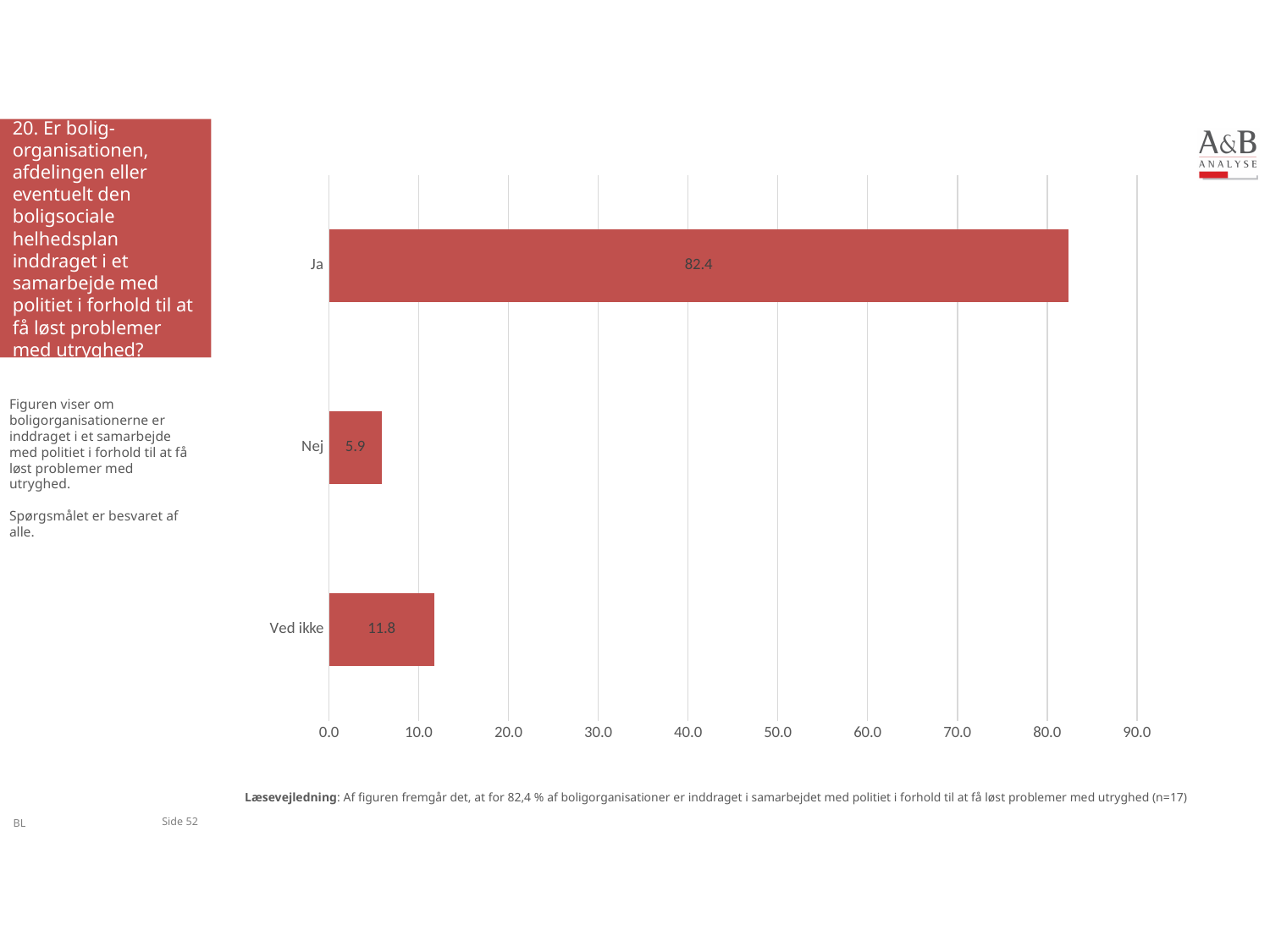
What is the difference between the values for "Ved ikke" and "Nej"? 5.9 What is the value for "Ja"? 82.4 Which category has the highest value? Ja Which is larger, the value for "Nej" or the value for "Ved ikke"? Ved ikke What is the difference between the values for "Ja" and "Ved ikke"? 70.6 What is the value for "Nej"? 5.9 What is the value for "Ved ikke"? 11.8 Which category has the lowest value? Nej What kind of chart is shown on the slide? bar chart Is the value for "Ja" greater or less than 80.0? greater What is the highest tick value shown on the horizontal axis? 90.0 How many categories are shown in the chart? 3